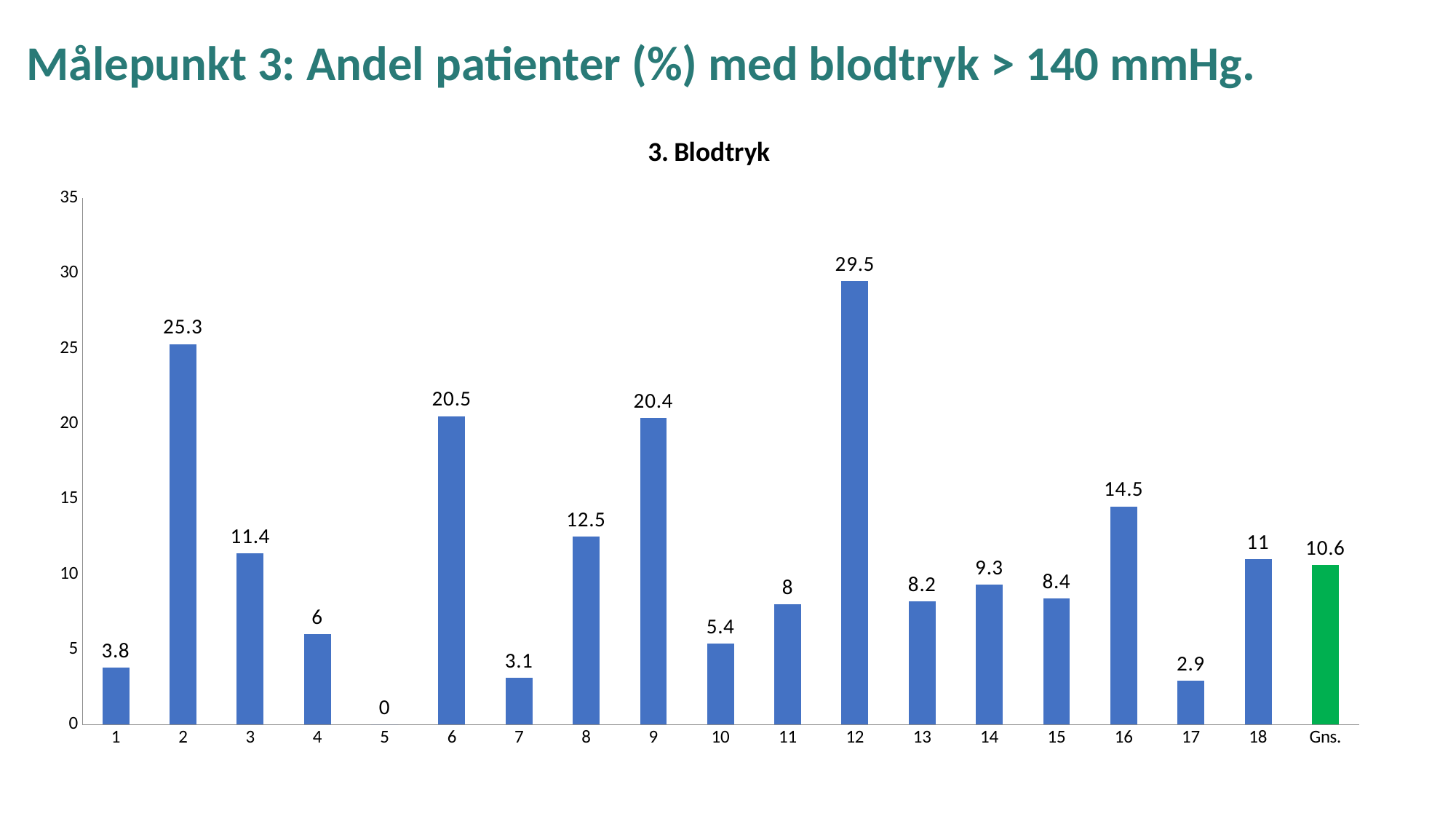
What is the title of the chart? 3. Blodtryk What kind of chart is shown? bar chart How many bars are plotted in the chart, including Gns.? 19 Which category has the lowest value? 5 What is the difference between the values for category 12 and category 2? 4.2 Which category has the highest value? 12 What is the value for category 12? 29.5 What is the value shown for Gns.? 10.6 Is the value for category 3 greater or less than 10? greater Which is larger, the value for category 16 or the value for category 8? 16 What is the value for category 2? 25.3 Which bar is coloured green instead of blue? Gns.